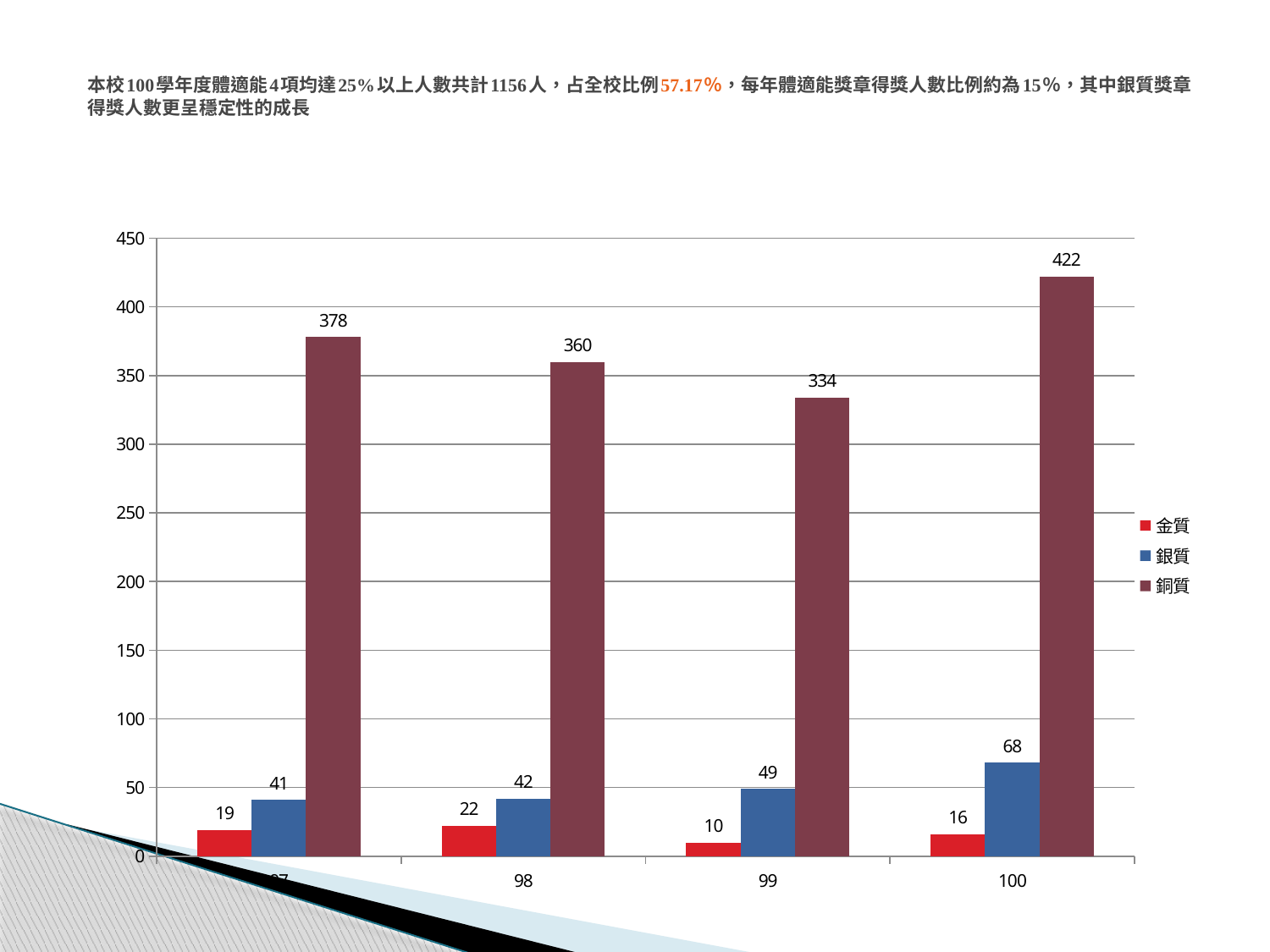
What is the value for 銅質 in 100? 422 What type of chart is shown on the slide? bar chart What is the value for 銀質 in 99? 49 In which year is the 金質 value the lowest? 99 How many series does the legend list? 3 How many year groups are plotted on the x axis? 4 In which year is the 銅質 value the highest? 100 What is the difference between the 銅質 values for 100 and 99? 88 What is the value for 金質 in 98? 22 Which colour represents 銀質 in the legend? blue Is the value for 銅質 in 99 greater or less than 300? greater Which is larger, the 銀質 value for 100 or the 銀質 value for 98? 100